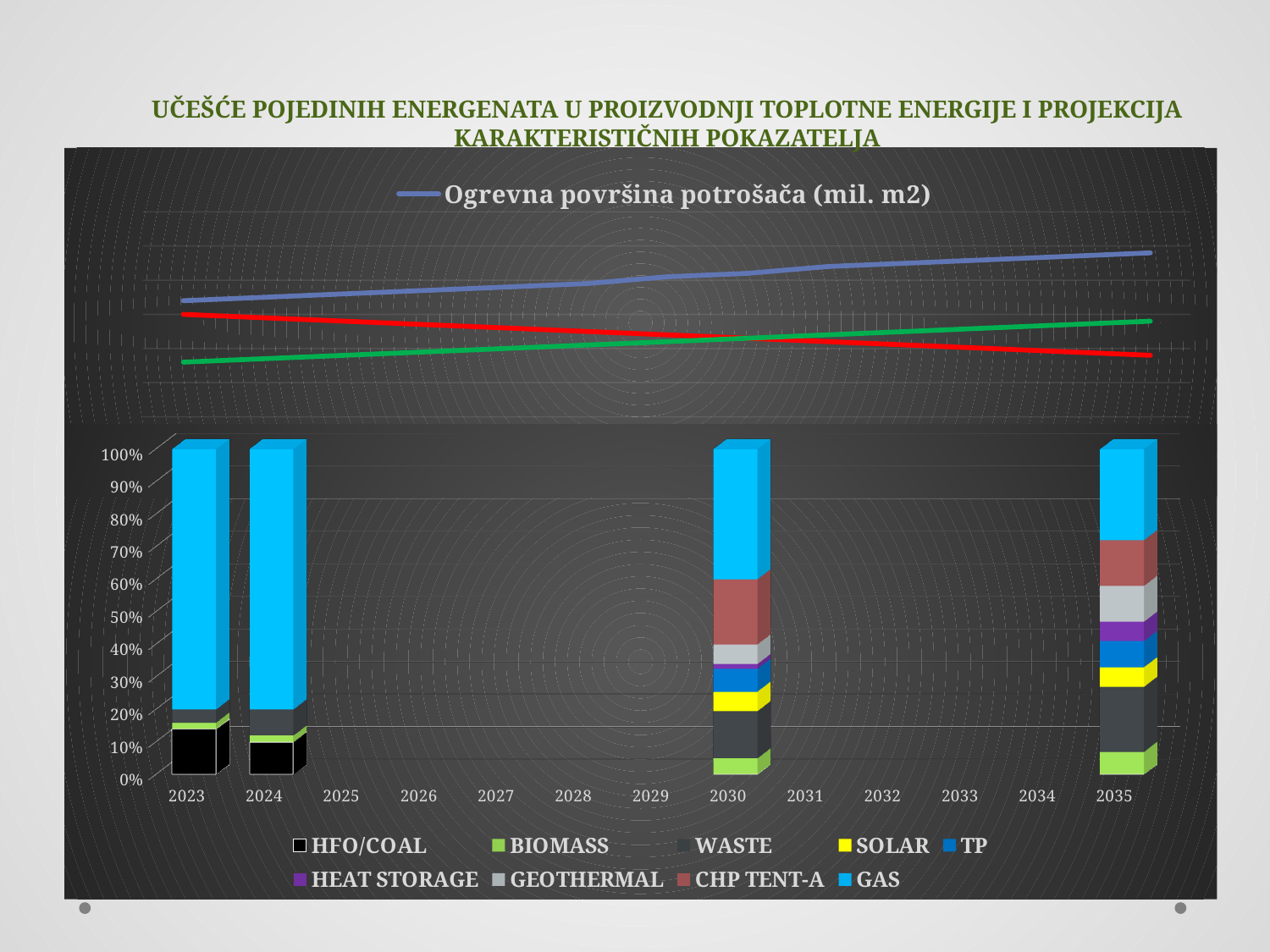
What kind of chart is the upper chart titled 'Ogrevna površina potrošača (mil. m2)'? line chart In the lower stacked bar chart, is the GAS share larger in 2023 or in 2035? 2023 What kind of chart is the lower chart on the slide? stacked bar chart In the upper line chart, does the red line rise or fall from left to right? fall In the upper line chart, does the blue line rise or fall from 2023 to 2035? rise In the lower stacked bar chart, which legend entry is shown in light blue? GAS In the lower stacked bar chart, how many years actually have a bar plotted? 4 In the lower stacked bar chart, how many year labels are shown on the x axis? 13 In the lower stacked bar chart, how many series does the legend list? 9 In the lower stacked bar chart, which plotted year has the smallest GAS share? 2035 In the lower stacked bar chart, is the GAS share of the 2035 bar greater or less than 50%? less In the lower stacked bar chart, is the GAS share of the 2023 bar greater or less than 70%? greater